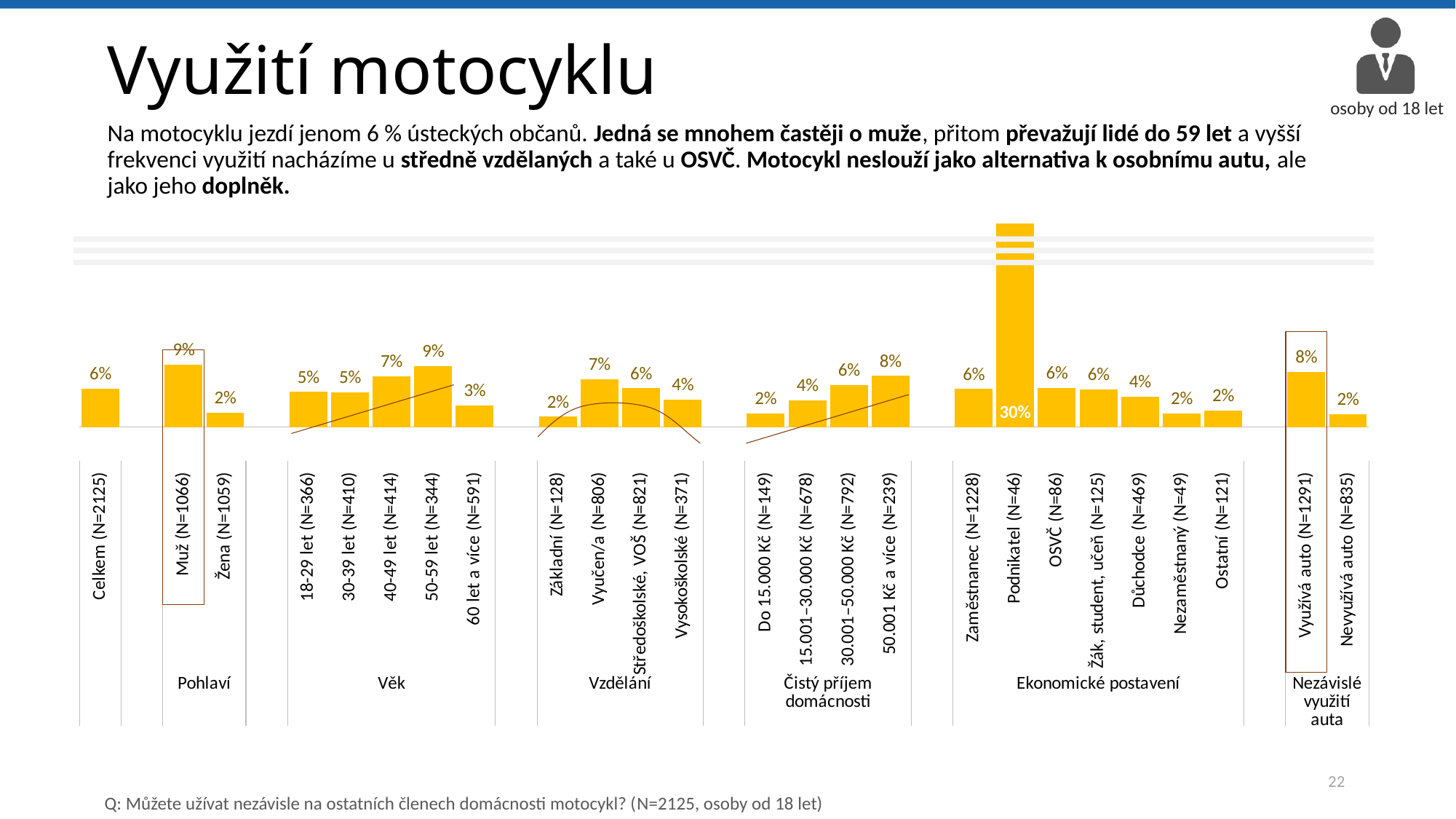
What kind of chart is shown on the slide? bar chart Which category has the highest value in the chart? Podnikatel (N=46) What is the value for 50-59 let (N=344)? 9% What is the value for Vysokoškolské (N=371)? 4% Which is larger, the value for Vyučen/a (N=806) or the value for Základní (N=128)? Vyučen/a (N=806) What is the value for Celkem (N=2125)? 6% How many categories are plotted in the chart? 25 What is the difference between the values for Muž (N=1066) and Žena (N=1059)? 7% What is the difference between the values for Využívá auto (N=1291) and Nevyužívá auto (N=835)? 6% Within the Pohlaví group, which category has the lowest value? Žena (N=1059) Do the values rise or fall across the Čistý příjem domácnosti categories from Do 15.000 Kč to 50.001 Kč a více? rise What is the value for Podnikatel (N=46)? 30%